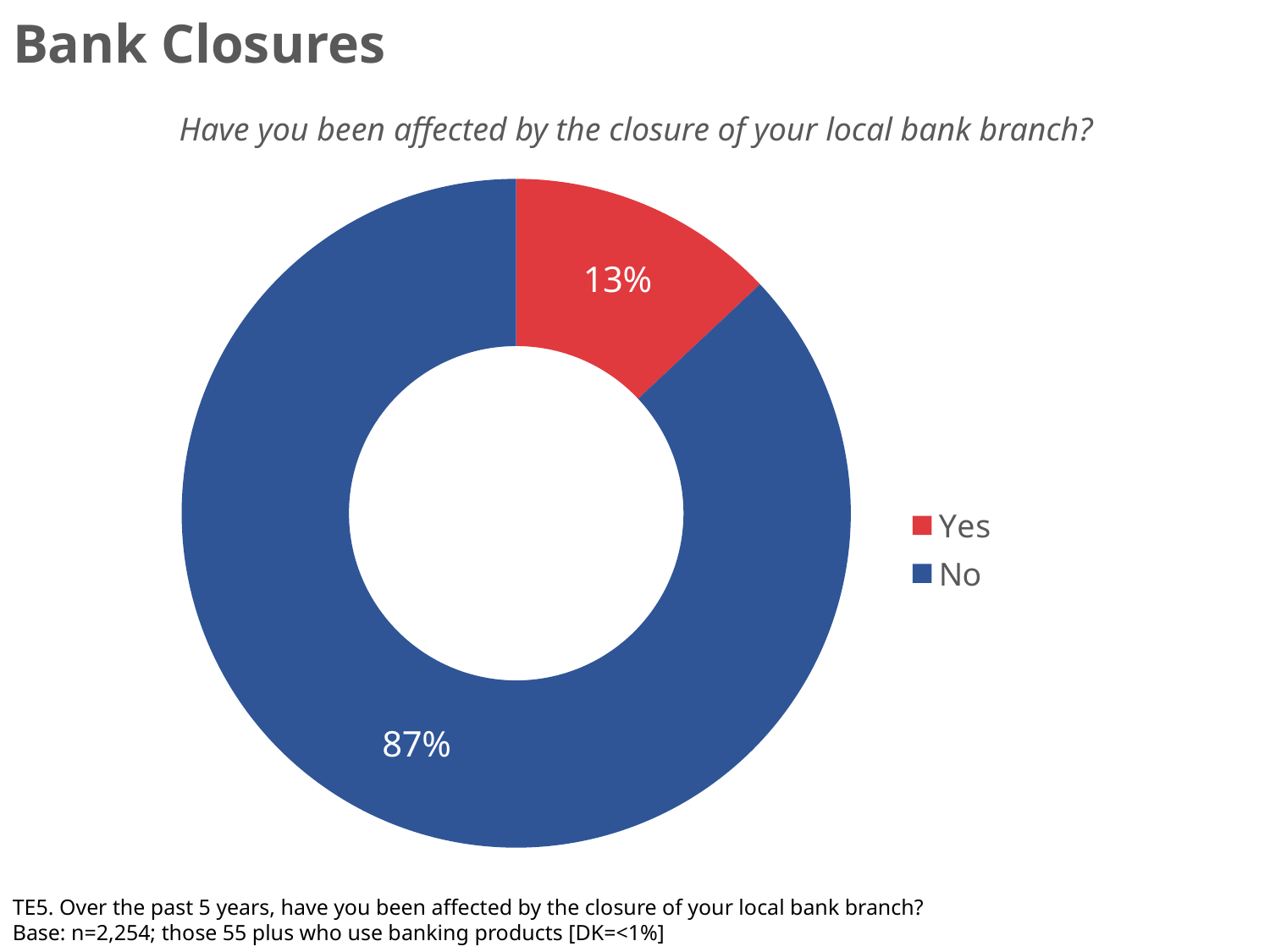
How many entries does the legend list? 2 What is the difference in percentage points between the No and Yes responses? 74 Which response has the smallest share of the chart? Yes Which is larger, the share answering Yes or the share answering No? No What question is shown as the chart's title? Have you been affected by the closure of your local bank branch? What percentage of respondents answered No to being affected by the closure of their local bank branch? 87% What percentage of respondents answered Yes to being affected by the closure of their local bank branch? 13% What kind of chart is shown on the slide? Doughnut (pie) chart What share of the chart does the Yes slice represent? 13% How many categories does the chart show? 2 Which response has the largest share of the chart? No What colour is the Yes slice in the chart? Red